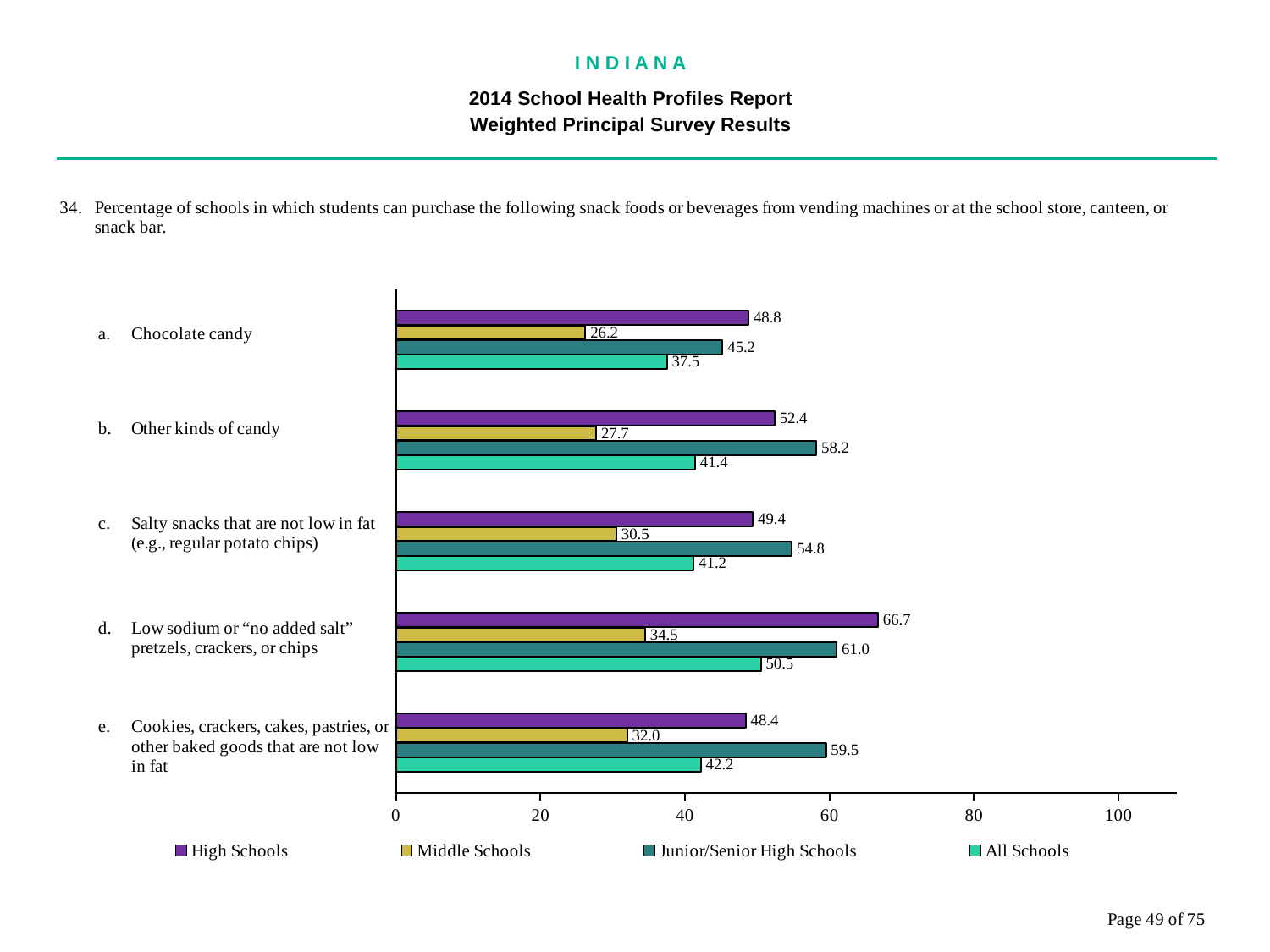
What is the difference between the High Schools and Middle Schools values for Other kinds of candy? 24.7 What is the value for Junior/Senior High Schools for Cookies, crackers, cakes, pastries, or other baked goods that are not low in fat? 59.5 Which category has the highest value for All Schools? Low sodium or "no added salt" pretzels, crackers, or chips How many series does the legend list? 4 What kind of chart is shown on the slide? Bar chart What is the value for Middle Schools for Low sodium or "no added salt" pretzels, crackers, or chips? 34.5 Which series is shown in the legend with a yellow colour? Middle Schools Which category has the lowest value for Middle Schools? Chocolate candy How many snack food categories are shown in the chart? 5 What is the value for High Schools for Chocolate candy? 48.8 Is the value for High Schools for Low sodium or "no added salt" pretzels, crackers, or chips greater or less than 60? greater For Salty snacks that are not low in fat, which is larger: the High Schools value or the Junior/Senior High Schools value? Junior/Senior High Schools